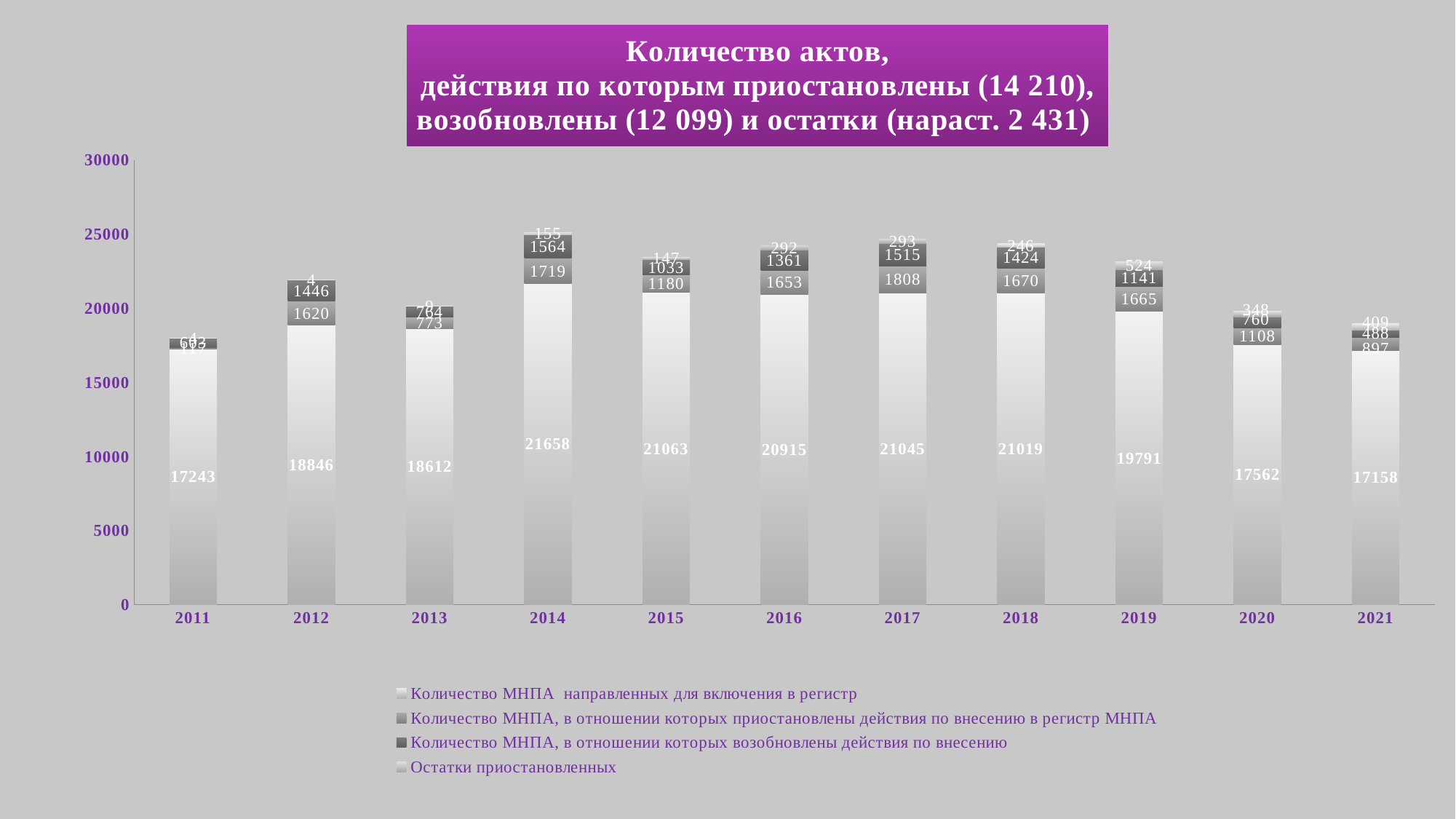
What kind of chart is shown on the slide? Stacked bar chart What is the value of 'Количество МНПА, в отношении которых возобновлены действия по внесению' for 2019? 1141 What is the value of 'Остатки приостановленных' for 2021? 409 How many years are shown on the x axis? 11 What is the value of 'Количество МНПА направленных для включения в регистр' for 2014? 21658 How many series does the legend list? 4 Which year has the larger value for 'Количество МНПА, в отношении которых приостановлены действия по внесению в регистр МНПА': 2017 or 2018? 2017 Which year has the lowest value for 'Количество МНПА направленных для включения в регистр'? 2021 What is the total of the stacked bar for 2014? 25096 What is the difference between the 'Количество МНПА направленных для включения в регистр' values for 2014 and 2015? 595 What is the value of 'Количество МНПА, в отношении которых приостановлены действия по внесению в регистр МНПА' for 2017? 1808 Which year has the highest value for 'Количество МНПА направленных для включения в регистр'? 2014